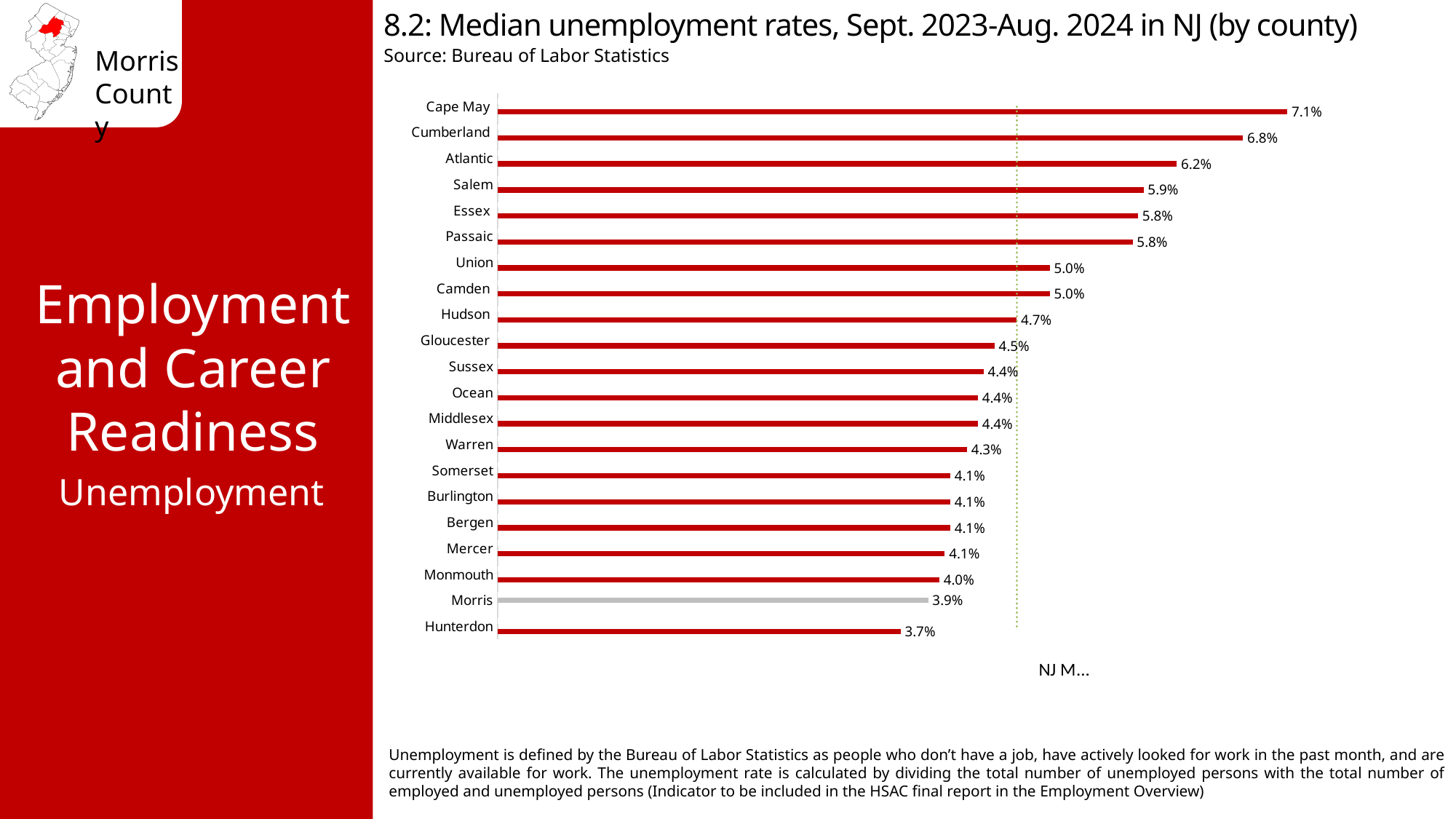
What is the difference between the median unemployment rates of Cape May and Hunterdon? 3.4% What kind of chart is shown on the slide? Bar chart What is the median unemployment rate for Morris? 3.9% Which county's bar is shown in a different colour (grey) from the others? Morris Which county has a higher median unemployment rate, Monmouth or Morris? Monmouth Which county has the lowest median unemployment rate? Hunterdon What is the difference between the median unemployment rates of Cumberland and Morris? 2.9% Which county has the highest median unemployment rate? Cape May What is the median unemployment rate for Hudson? 4.7% What is the median unemployment rate for Cape May? 7.1% How many counties are shown in the chart? 21 Which county has a higher median unemployment rate, Atlantic or Salem? Atlantic